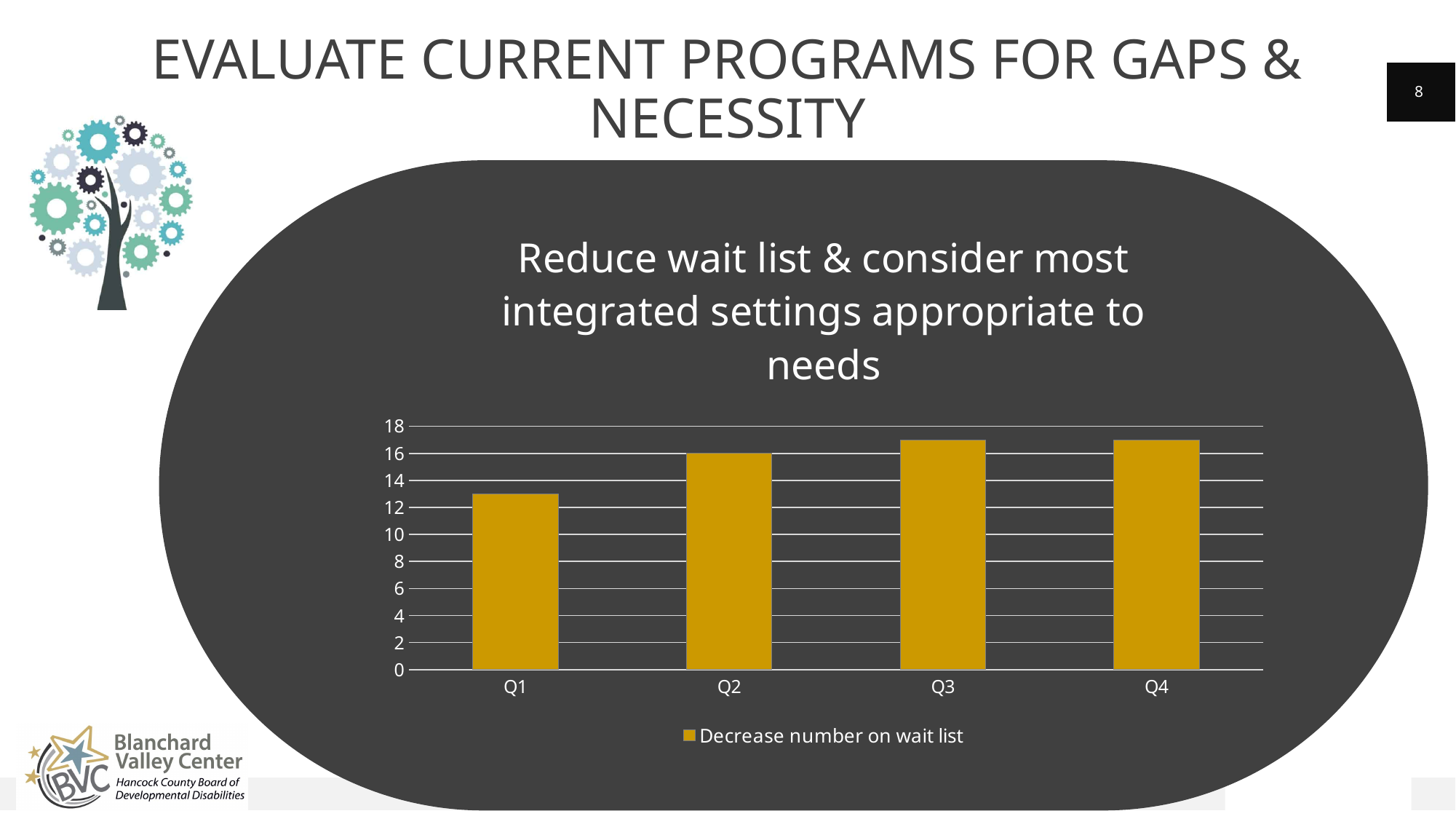
How many series does the chart legend list? 1 Is the value for Q3 greater or less than 16? greater Which is larger, the value for Q1 or the value for Q2? Q2 Is the value for Q1 greater or less than 14? less What type of chart is shown on the slide? Bar chart Is the value for Q4 greater or less than 18? less How many categories are shown on the x axis of the chart? 4 What is the value for Q2 in the chart? 16 Which quarter has the lowest value in the chart? Q1 Do the values generally rise or fall from Q1 to Q4? Rise What is the series name shown in the chart legend? Decrease number on wait list